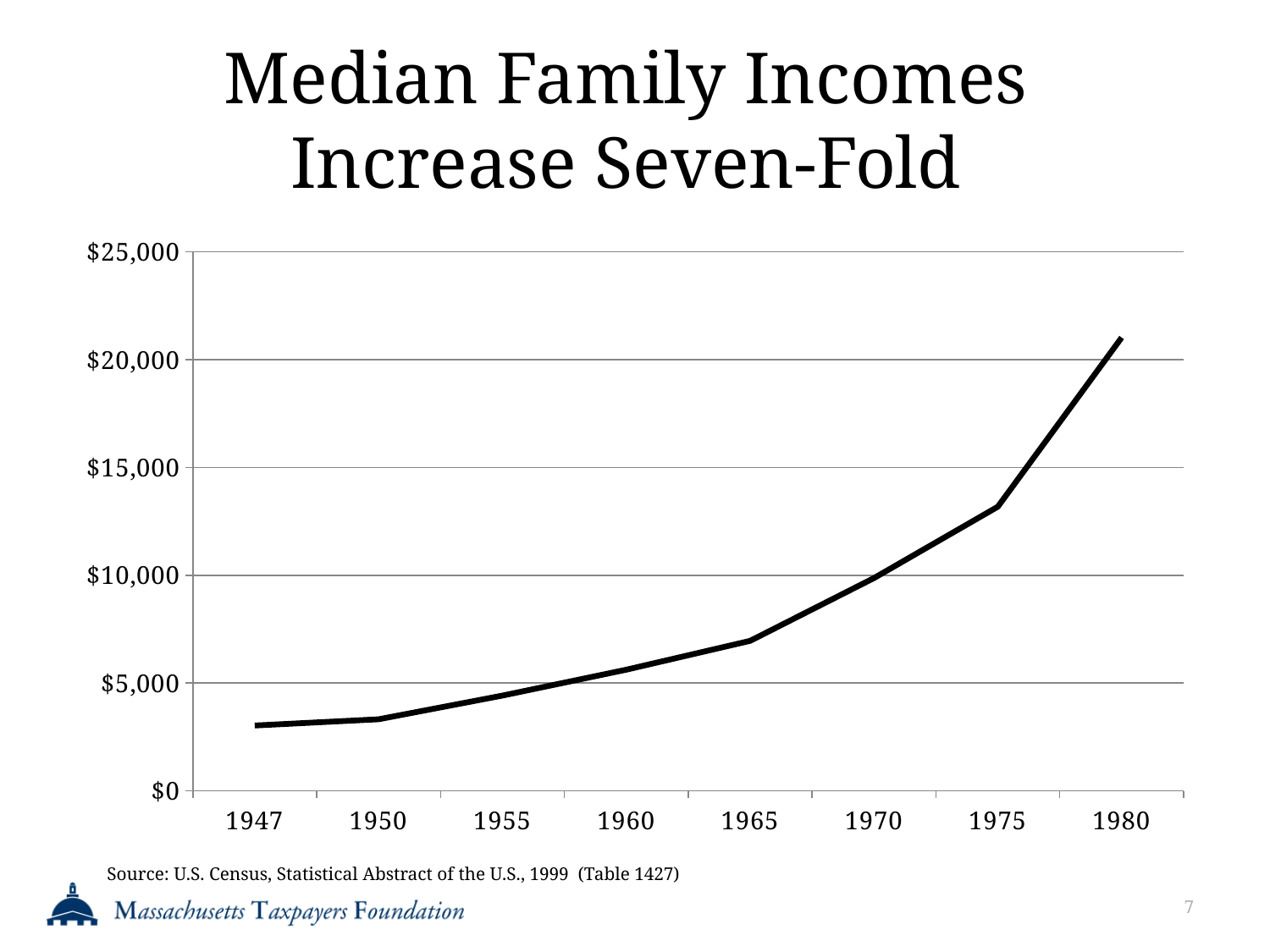
Which year has the lowest median family income? 1947 What source is cited below the chart? U.S. Census, Statistical Abstract of the U.S., 1999 (Table 1427) Is the value for 1980 greater or less than $20,000? greater How many years are plotted along the x axis? 8 Do median family incomes rise or fall from 1947 to 1980? rise Which year has the highest median family income? 1980 Is the value for 1947 greater or less than $5,000? less What kind of chart is shown on the slide? line chart Is the value for 1965 greater or less than $5,000? greater What is the title of the chart on the slide? Median Family Incomes Increase Seven-Fold Which year has the larger median family income, 1975 or 1980? 1980